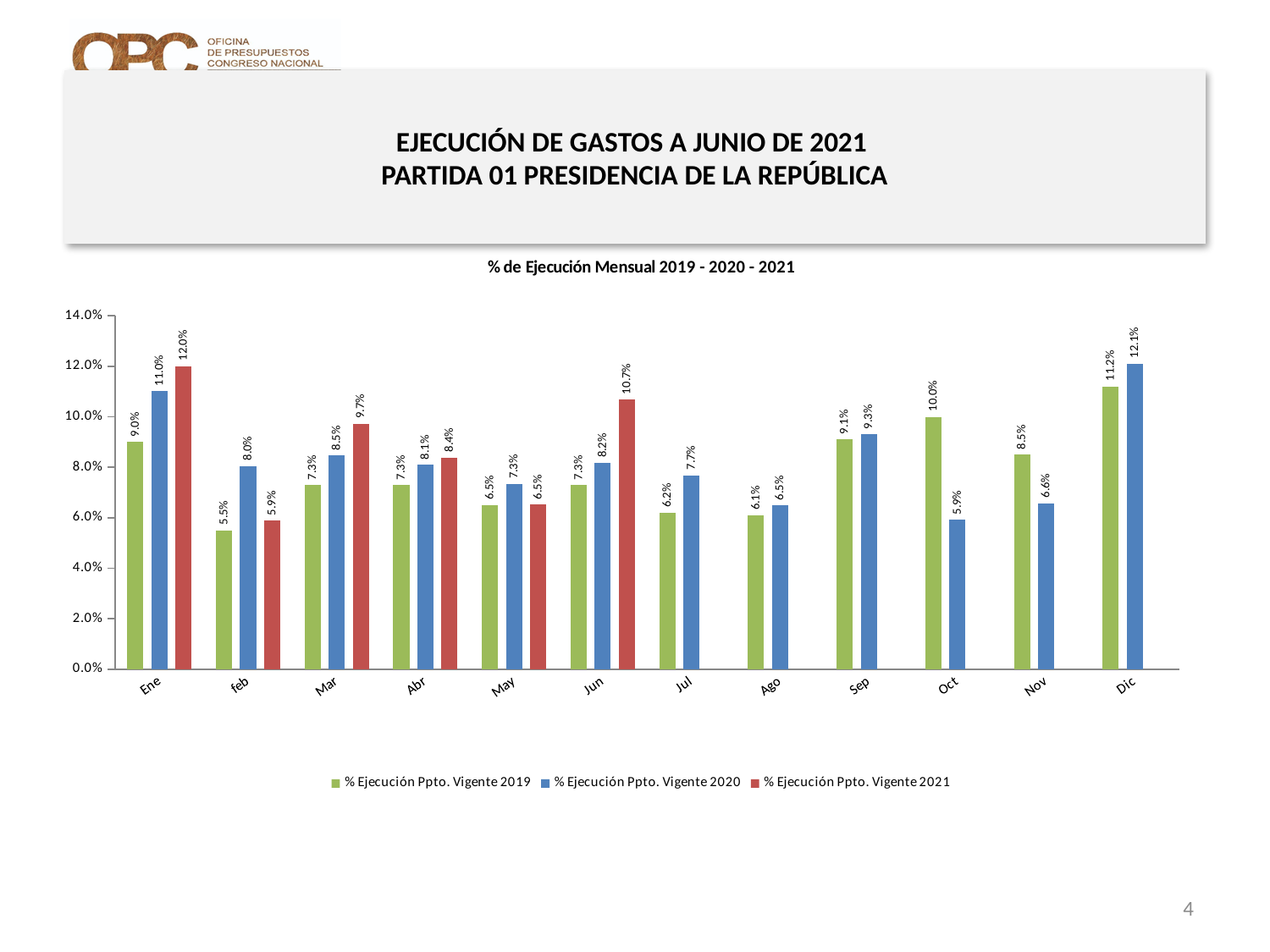
Which month has the highest value for % Ejecución Ppto. Vigente 2020? Dic What is the title of the chart? % de Ejecución Mensual 2019 - 2020 - 2021 Is the value for % Ejecución Ppto. Vigente 2021 in Mar greater or less than 8.0%? greater What is the value for % Ejecución Ppto. Vigente 2019 in Oct? 10.0% How many months are shown on the x axis? 12 How many series does the legend list? 3 What kind of chart is shown? Bar chart What is the value for % Ejecución Ppto. Vigente 2020 in Jun? 8.2% What is the difference between the 2021 and 2019 values in Jun? 3.4% In Oct, which is larger: the 2019 value or the 2020 value? 2019 Which month has the lowest value for % Ejecución Ppto. Vigente 2019? feb What is the value for % Ejecución Ppto. Vigente 2021 in Ene? 12.0%